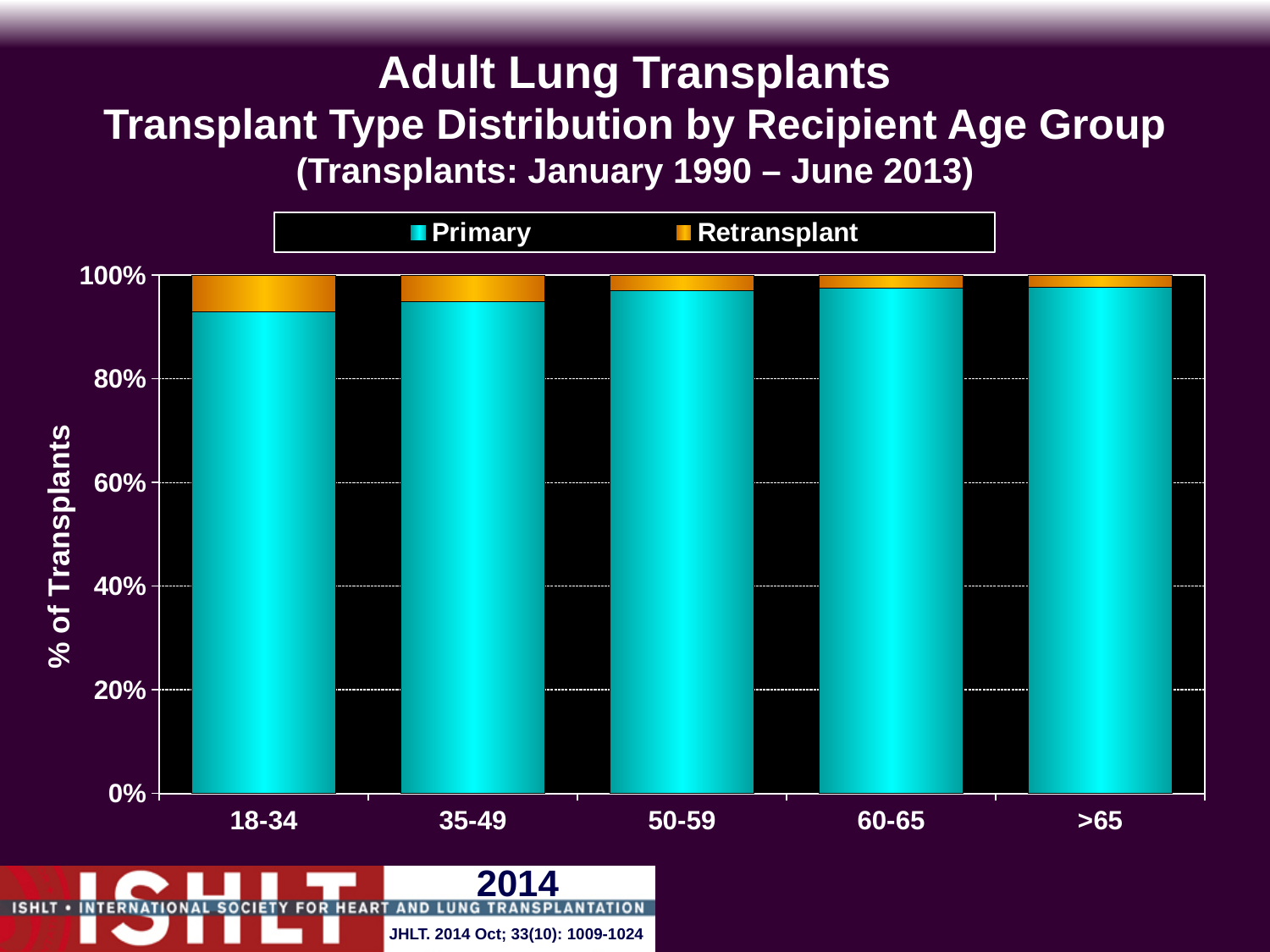
Which is larger, the Retransplant share for 18-34 or for >65? 18-34 Which age group has the lowest Primary share? 18-34 Does the Retransplant share rise or fall as recipient age group increases along the x axis? fall Is the Retransplant value for the 18-34 age group greater or less than 20%? less How many recipient age groups are shown on the x axis? 5 Which age group has the highest Retransplant share? 18-34 Is the Primary value for the 18-34 age group greater or less than 80%? greater What kind of chart is shown on the slide? stacked bar chart Which is larger, the Primary share for 18-34 or for 35-49? 35-49 How many series does the legend list? 2 What is the label of the y axis? % of Transplants Is the Primary value for the >65 age group greater or less than 90%? greater